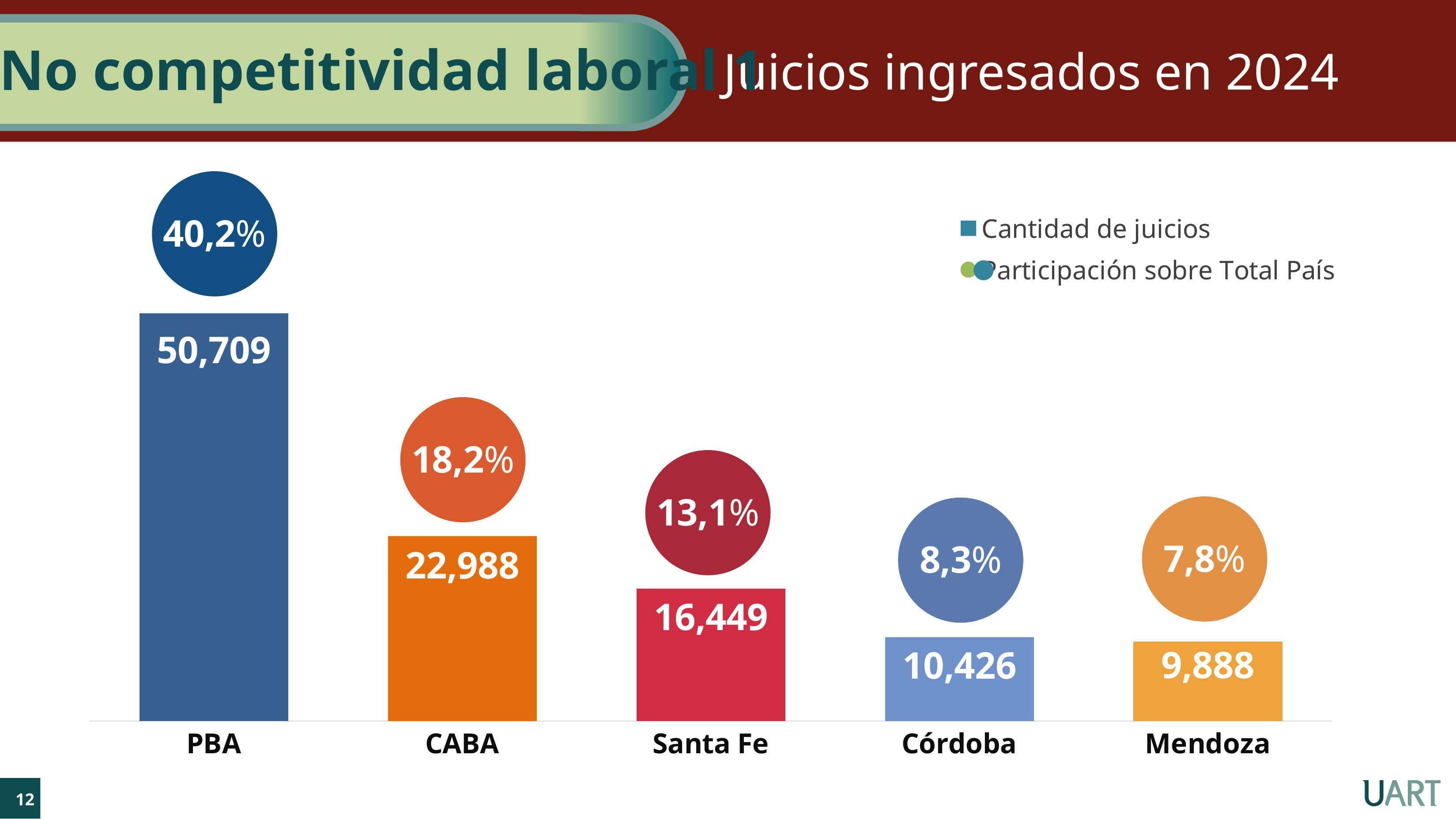
How many series does the chart legend list? 2 How many categories are shown on the x axis of the chart? 5 Which category has the lowest Cantidad de juicios? Mendoza Which category has the highest Cantidad de juicios? PBA What is the Cantidad de juicios value for PBA? 50,709 What is the difference in Cantidad de juicios between Córdoba and Mendoza? 538 What kind of chart is shown on the slide? Bar chart What is the Cantidad de juicios value for Santa Fe? 16,449 Which has a larger Cantidad de juicios, CABA or Santa Fe? CABA What is the Participación sobre Total País value for CABA? 18,2% What is the Participación sobre Total País value for Mendoza? 7,8% What is the difference in Cantidad de juicios between PBA and CABA? 27,721